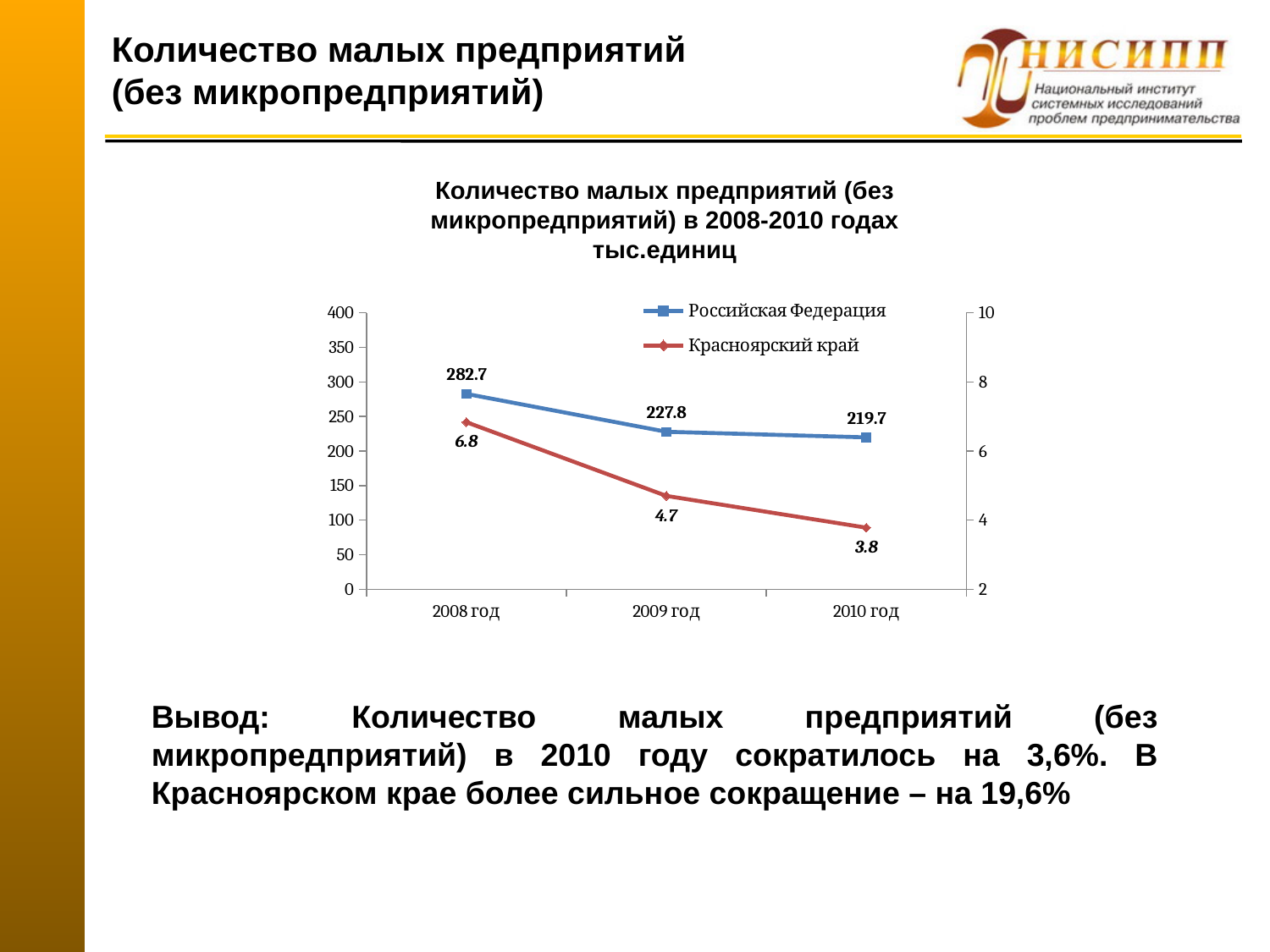
How many series does the legend list? 2 What is the difference between the Российская Федерация values for 2008 год and 2009 год? 54.9 What is the value for Российская Федерация in 2008 год? 282.7 In which year is the value for Красноярский край lowest? 2010 год What is the value for Красноярский край in 2010 год? 3.8 What is the value for Российская Федерация in 2010 год? 219.7 Do the values for Красноярский край rise or fall from 2008 год to 2010 год? fall What type of chart is shown on the slide? line chart How many years are shown on the x axis? 3 What is the value for Красноярский край in 2009 год? 4.7 What is the difference between the Красноярский край values for 2008 год and 2010 год? 3.0 In which year is the value for Российская Федерация highest? 2008 год